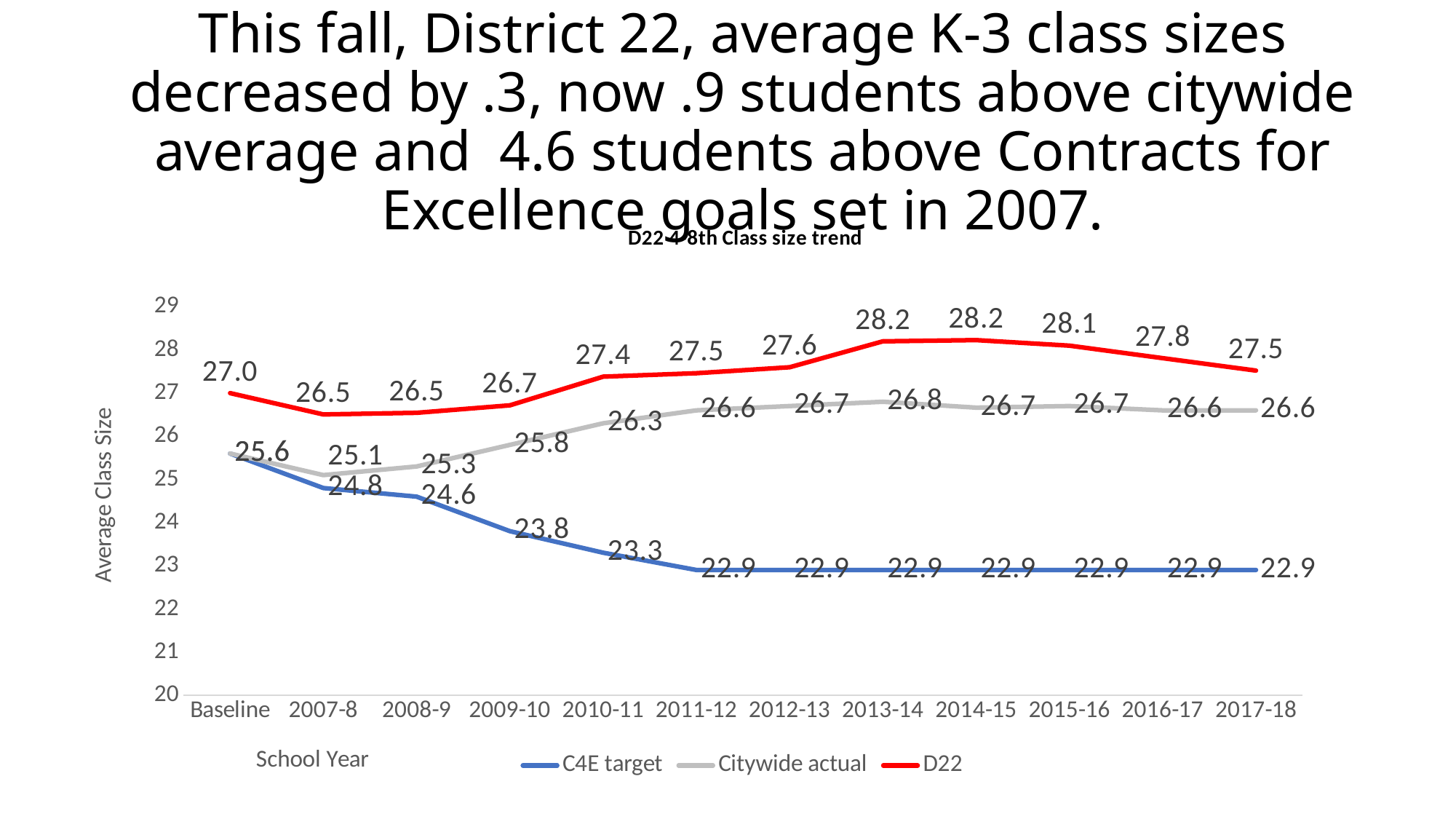
What is the D22 value for 2017-18? 27.5 How many school years are shown on the x axis? 12 In which school year is the C4E target value highest? Baseline What kind of chart is shown on the slide? line chart At Baseline, which is larger: the D22 value or the Citywide actual value? D22 What is the difference between the D22 value and the C4E target value in 2017-18? 4.6 What is the Citywide actual value for 2013-14? 26.8 How many series does the legend list? 3 In which school year is the Citywide actual value highest? 2013-14 Is the D22 value for 2014-15 greater or less than 28? greater What is the difference between the D22 value and the Citywide actual value in 2017-18? 0.9 What is the C4E target value for 2009-10? 23.8